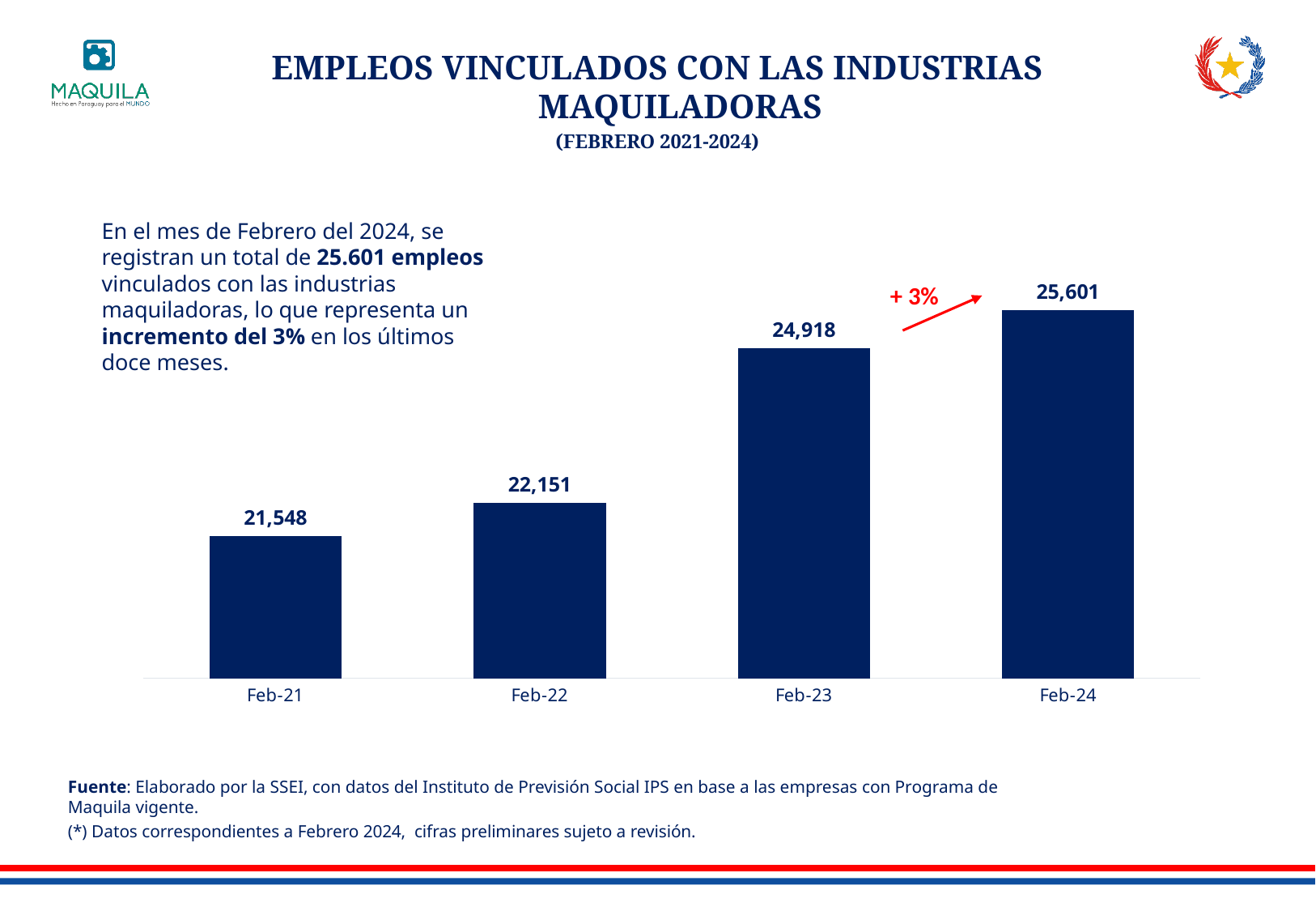
What kind of chart is shown on the slide? Bar chart What is the value for Feb-22? 22,151 What is the value for Feb-24? 25,601 What is the value for Feb-23? 24,918 How many categories are shown on the x axis? 4 Do the values rise or fall from Feb-21 to Feb-24? Rise What is the value for Feb-21? 21,548 Which is larger, the value for Feb-23 or the value for Feb-22? Feb-23 Which category has the highest value? Feb-24 What is the difference between the values for Feb-24 and Feb-23? 683 What is the difference between the values for Feb-22 and Feb-21? 603 Which category has the lowest value? Feb-21